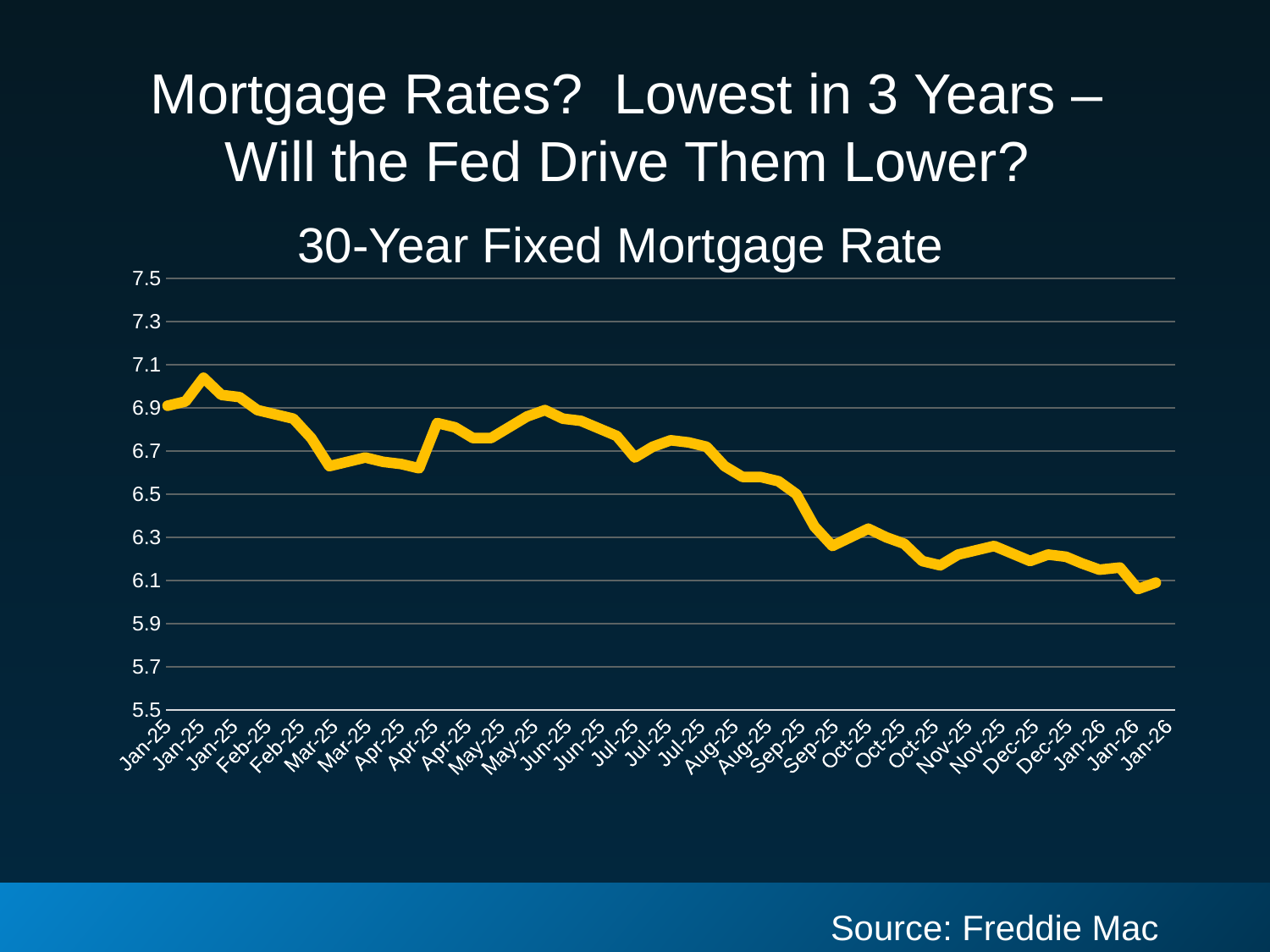
Is the value at the first Mar-25 point greater or less than 6.7? less What kind of chart is shown on the slide? line chart Does the 30-year fixed mortgage rate generally rise or fall from Jan-25 to Jan-26? fall Which is higher, the rate in Jun-25 or the rate in Nov-25? Jun-25 Is the value at the Dec-25 points greater or less than 6.5? less In which month does the line reach its highest point? Jan-25 Is the final value in Jan-26 greater or less than 6.3? less What source is cited for the chart data? Freddie Mac In which month does the line reach its lowest point? Jan-26 What is the title of the chart? 30-Year Fixed Mortgage Rate